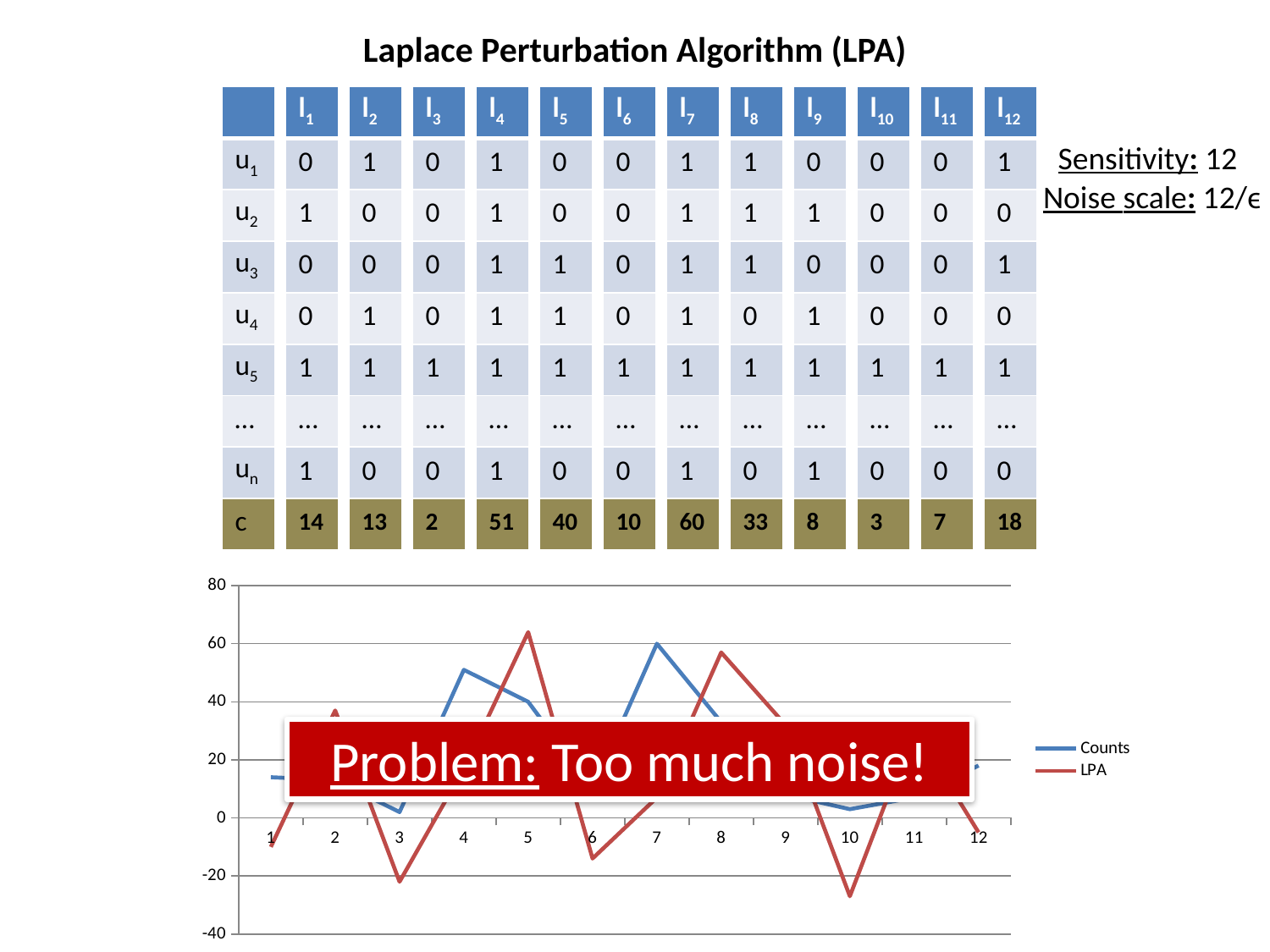
Is the value of the Counts series at x = 7 greater or less than 40? greater Is the value of the LPA series at x = 10 greater or less than 0? less Is the value of the Counts series at x = 1 greater or less than 20? less Which is larger: the LPA value at x = 5 or the LPA value at x = 10? x = 5 What kind of chart is shown at the bottom of the slide? line chart At which x-axis position does the Counts series reach its highest value? 7 How many points are plotted along the x axis of the chart? 12 How many series does the legend of the chart list? 2 Which is larger: the Counts value at x = 7 or the Counts value at x = 4? x = 7 What are the two series named in the chart legend? Counts and LPA Which colour is used for the LPA series in the chart? red